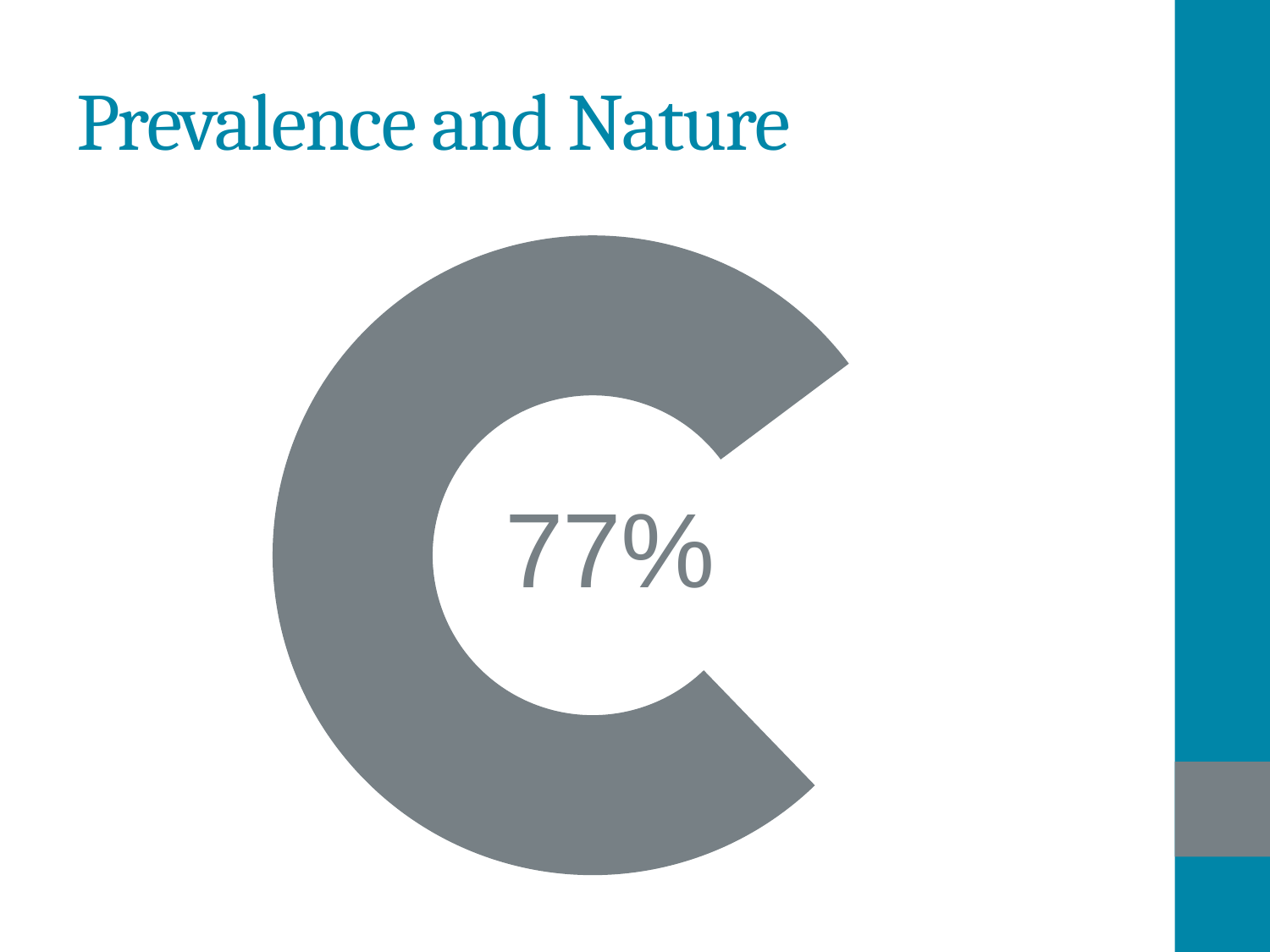
How many filled segments does the doughnut chart have? 1 What percentage is printed in the centre of the doughnut chart? 77% Is the grey segment of the doughnut chart larger or smaller than the unfilled portion? larger What share of the doughnut chart is left unfilled (not grey)? 23% Is the value shown on the doughnut chart greater or less than 50%? greater What kind of chart is shown on the slide? Doughnut chart What colour is the filled segment of the doughnut chart? Grey What share of the doughnut chart does the grey segment represent? 77% What is the title of the slide containing the doughnut chart? Prevalence and Nature